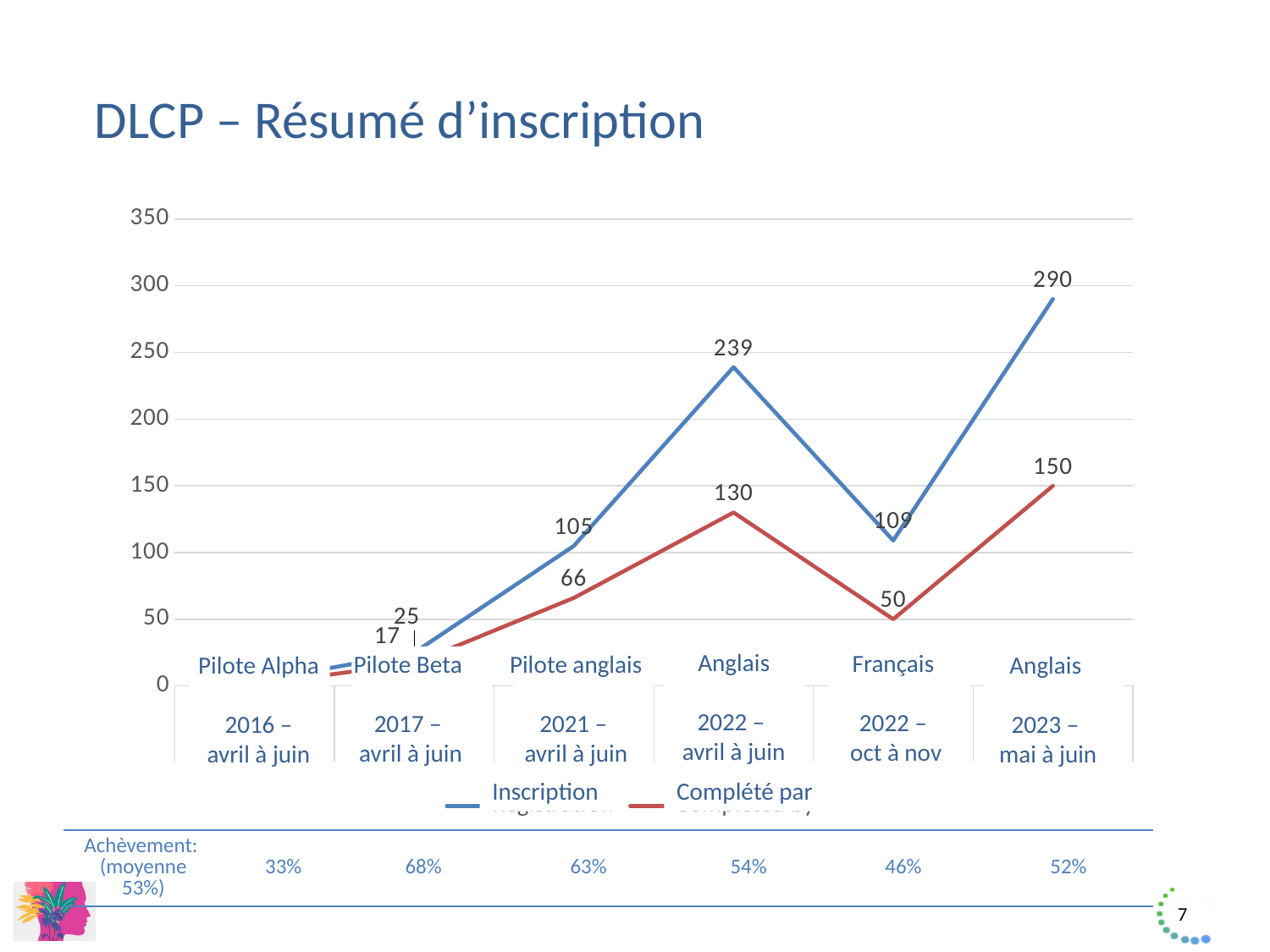
How many categories are plotted along the x axis? 6 What is the Inscription value for Français (2022 – oct à nov)? 109 Which category has the highest Inscription value? Anglais (2023 – mai à juin) Which category has the lowest Inscription value? Pilote Alpha What type of chart is shown on the slide? line chart What is the Inscription value for Anglais (2023 – mai à juin)? 290 What is the difference between Inscription and Complété par for Anglais (2023 – mai à juin)? 140 How many series does the legend list? 2 Is the Inscription value for Pilote Alpha greater or less than 50? less Does the Inscription line rise or fall from Pilote Beta to Anglais (2022 – avril à juin)? rise What is the Complété par value for Anglais (2022 – avril à juin)? 130 What is the Complété par value for Pilote anglais (2021 – avril à juin)? 66